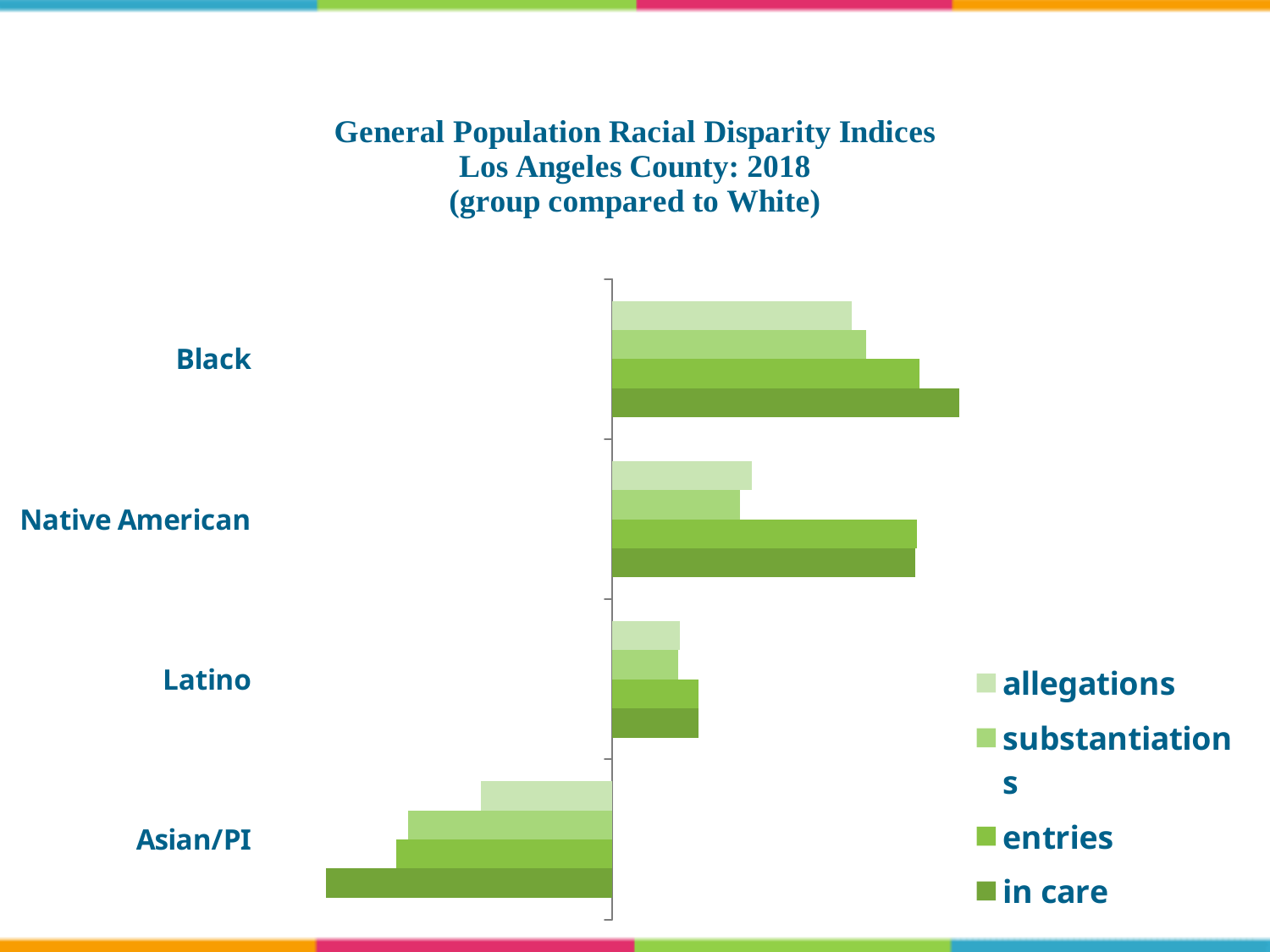
Which series is shown in the darkest green in the legend? in care Which group is the only one whose bars extend to the left of the axis (negative values)? Asian/PI Which group has the lowest 'in care' value? Asian/PI How many series does the legend list? 4 What kind of chart is shown on the slide? Bar chart Which group has the lowest 'allegations' value? Asian/PI Which group has the highest 'allegations' value? Black What is the title of the chart? General Population Racial Disparity Indices Los Angeles County: 2018 (group compared to White) Which group has the highest 'in care' value? Black For the Native American group, which is larger: the 'entries' value or the 'allegations' value? entries For the Black group, which is larger: the 'in care' value or the 'allegations' value? in care How many racial groups are plotted on the chart? 4